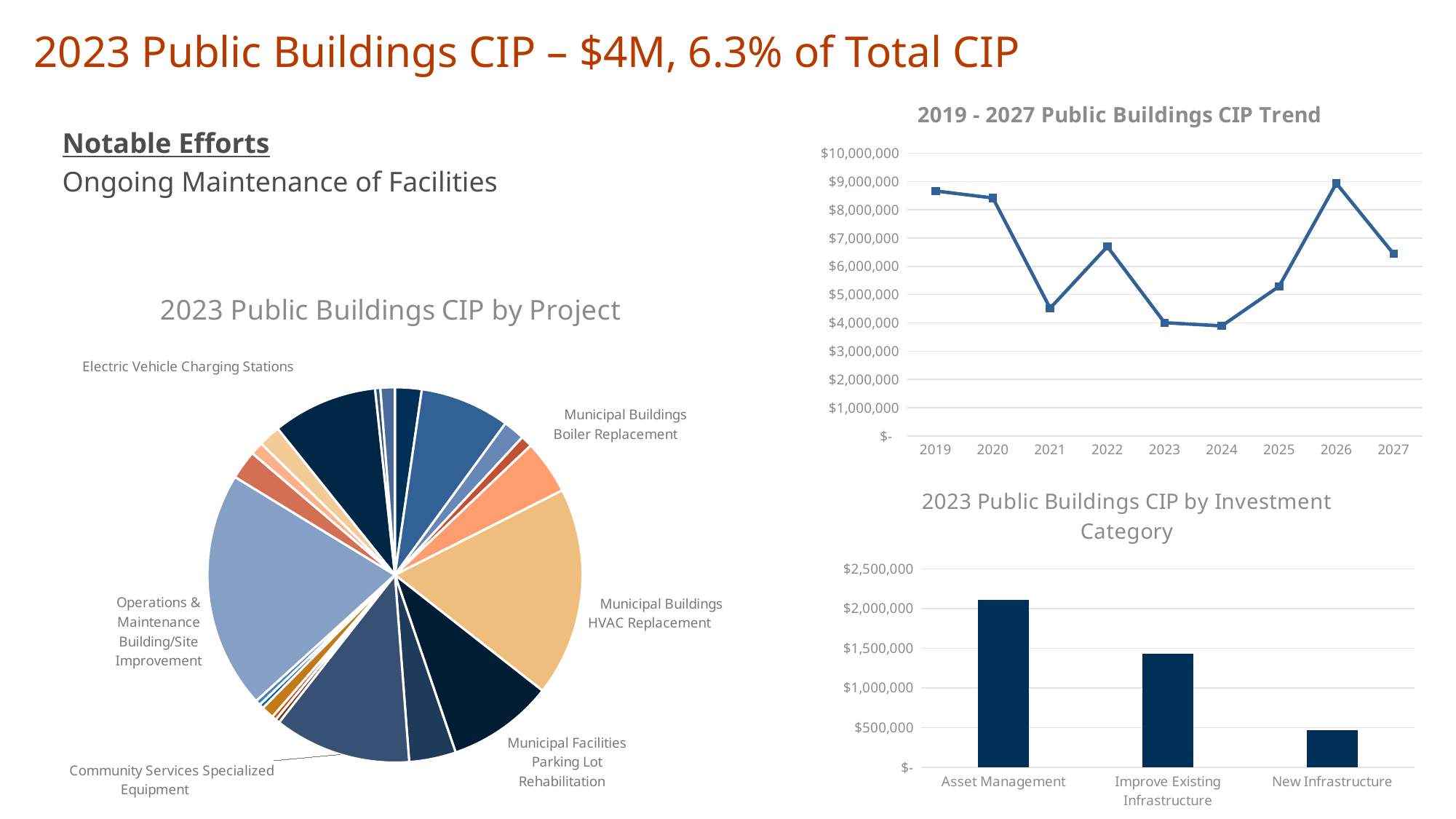
In the '2023 Public Buildings CIP by Investment Category' chart, which category has the highest value? Asset Management In the '2019 - 2027 Public Buildings CIP Trend' chart, is the value for 2021 greater or less than $5,000,000? less What kind of chart is the '2019 - 2027 Public Buildings CIP Trend' chart? line chart What kind of chart is the '2023 Public Buildings CIP by Project' chart? pie chart In the '2023 Public Buildings CIP by Investment Category' chart, which category has the lowest value? New Infrastructure What kind of chart is the '2023 Public Buildings CIP by Investment Category' chart? bar chart In the '2023 Public Buildings CIP by Investment Category' chart, how many categories are shown? 3 In the '2019 - 2027 Public Buildings CIP Trend' chart, do the values rise or fall from 2019 to 2021? fall In the '2019 - 2027 Public Buildings CIP Trend' chart, do the values rise or fall from 2024 to 2026? rise In the '2023 Public Buildings CIP by Investment Category' chart, is the value for Asset Management greater or less than $2,000,000? greater In the '2019 - 2027 Public Buildings CIP Trend' chart, is the value for 2022 greater or less than $6,000,000? greater In the '2019 - 2027 Public Buildings CIP Trend' chart, how many years are plotted on the x axis? 9